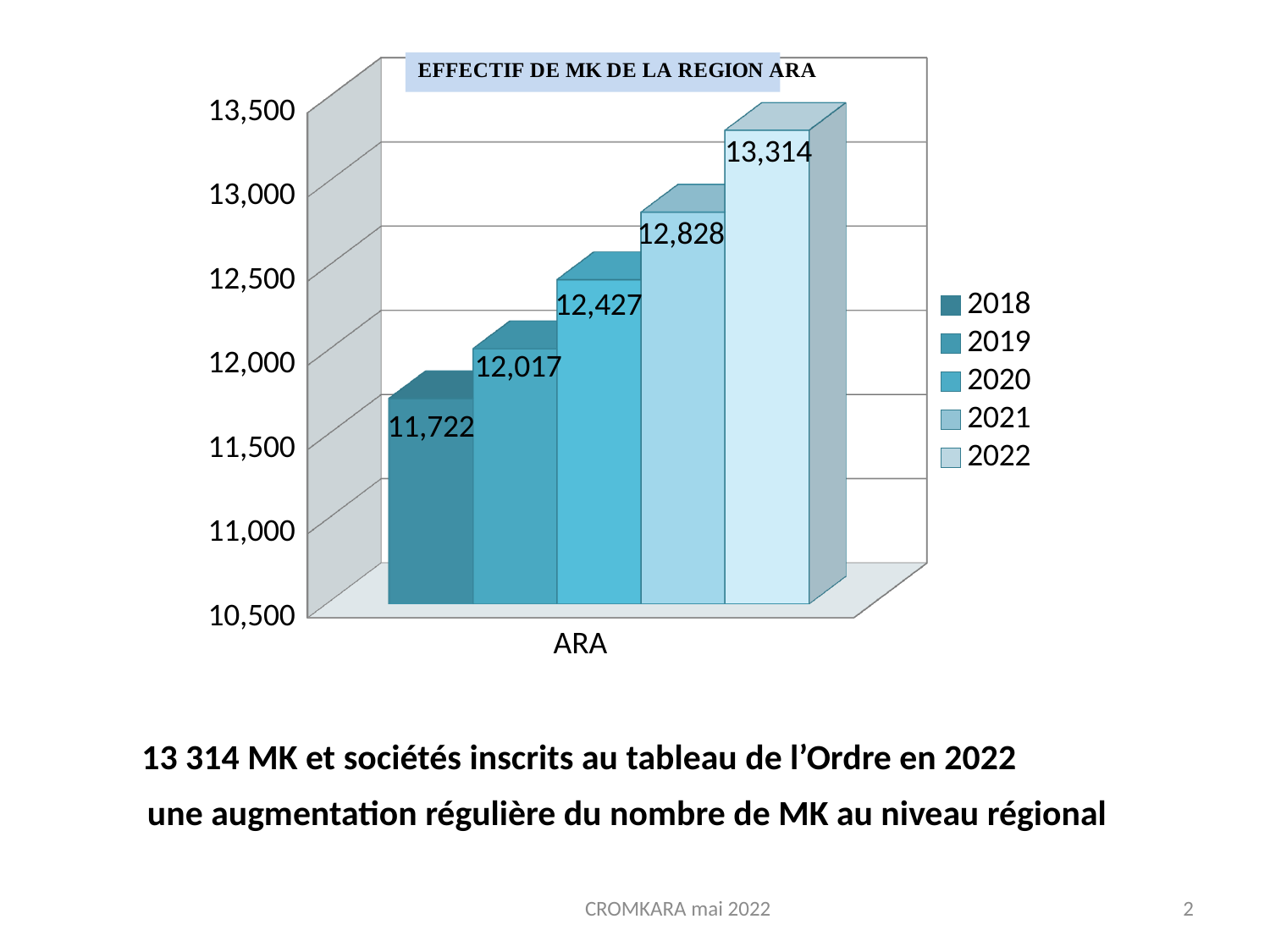
Which year has the lowest value? 2018 What kind of chart is shown on the slide? bar chart What is the title of the chart? EFFECTIF DE MK DE LA REGION ARA Is the value for 2019 greater or less than 12,500? less What is the value for 2022 in the chart? 13,314 What is the value for 2018 in the chart? 11,722 What is the difference between the values for 2021 and 2020? 401 How many series does the legend list? 5 What is the difference between the values for 2022 and 2018? 1,592 Which is larger, the value for 2019 or the value for 2021? 2021 Which year has the highest value? 2022 What is the value for 2020 in the chart? 12,427